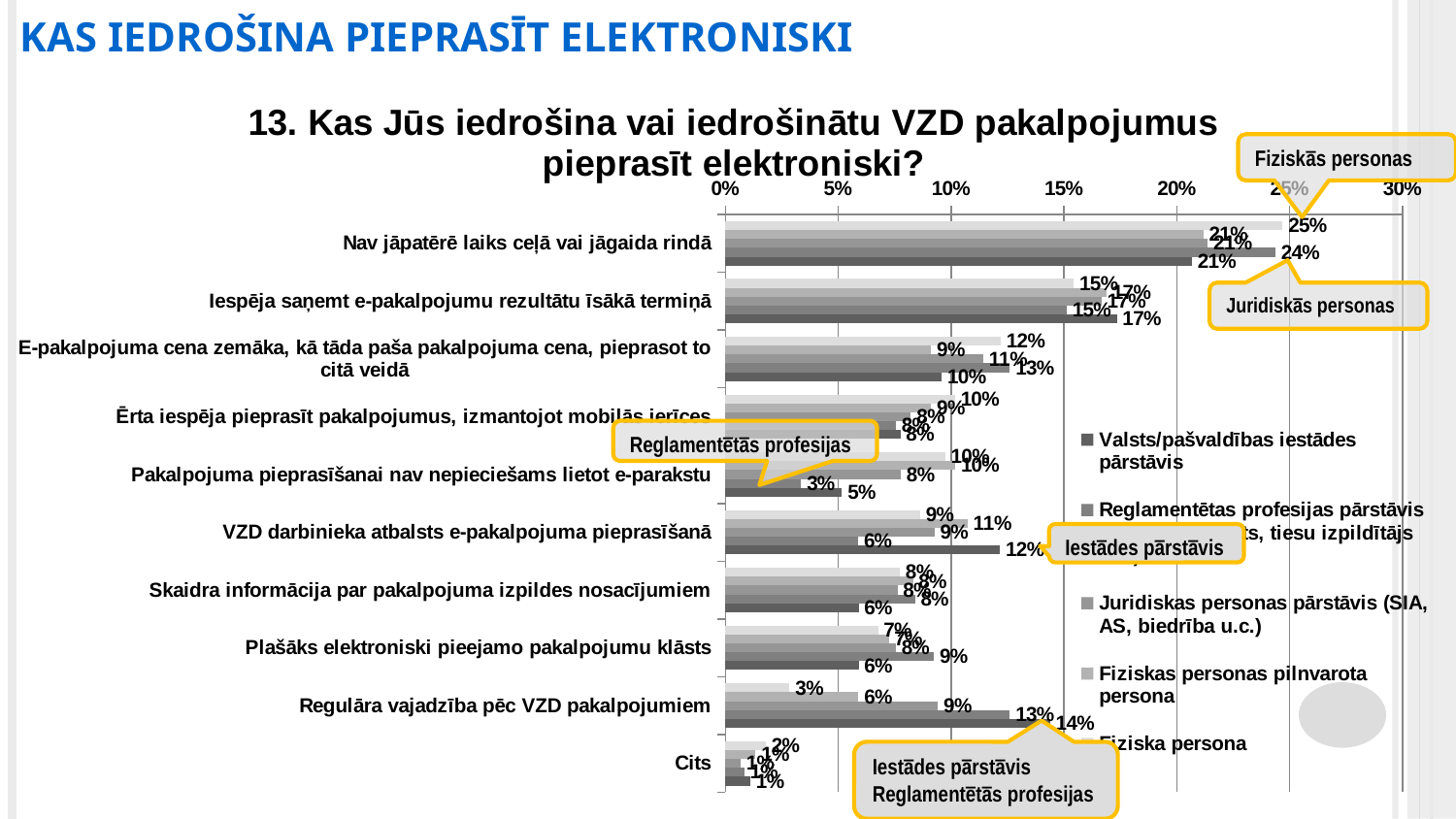
What is the difference between the highest (14%) and lowest (3%) labelled values for 'Regulāra vajadzība pēc VZD pakalpojumiem'? 11 percentage points What is the title of the chart? 13. Kas Jūs iedrošina vai iedrošinātu VZD pakalpojumus pieprasīt elektroniski? What is the lowest value labelled for the category 'Regulāra vajadzība pēc VZD pakalpojumiem'? 3% What kind of chart is shown on the slide? Bar chart How many series does the legend list? 5 Are the values for the category 'Cits' greater or less than 5%? less Which category has the lowest values in the chart? Cits Which category has the highest values in the chart? Nav jāpatērē laiks ceļā vai jāgaida rindā How many categories are plotted on the vertical axis of the chart? 10 What is the highest value labelled for the category 'Nav jāpatērē laiks ceļā vai jāgaida rindā'? 25% What is the highest value labelled for the category 'Regulāra vajadzība pēc VZD pakalpojumiem'? 14% Are the values for 'Nav jāpatērē laiks ceļā vai jāgaida rindā' greater or less than 20%? greater